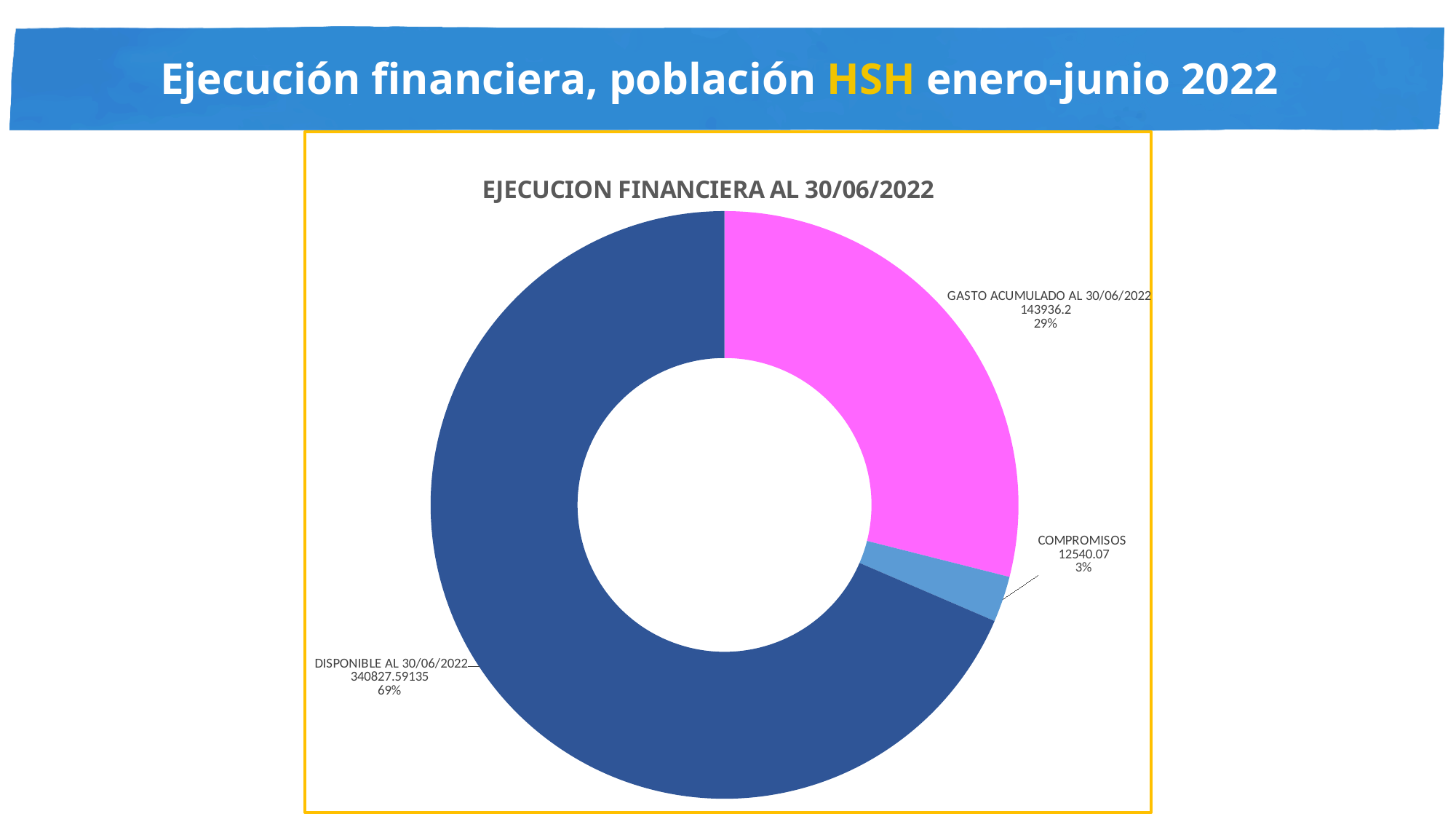
Which category has the largest value? DISPONIBLE AL 30/06/2022 How many categories does the chart show? 3 What share of the chart does DISPONIBLE AL 30/06/2022 represent? 69% What share of the chart does GASTO ACUMULADO AL 30/06/2022 represent? 29% Which is larger, GASTO ACUMULADO AL 30/06/2022 or COMPROMISOS? GASTO ACUMULADO AL 30/06/2022 What is the title of the chart? EJECUCION FINANCIERA AL 30/06/2022 Which category has the smallest value? COMPROMISOS What is the value for GASTO ACUMULADO AL 30/06/2022? 143936.2 What kind of chart is shown on the slide? doughnut chart What is the value for COMPROMISOS? 12540.07 What share of the chart does COMPROMISOS represent? 3% What is the value for DISPONIBLE AL 30/06/2022? 340827.59135